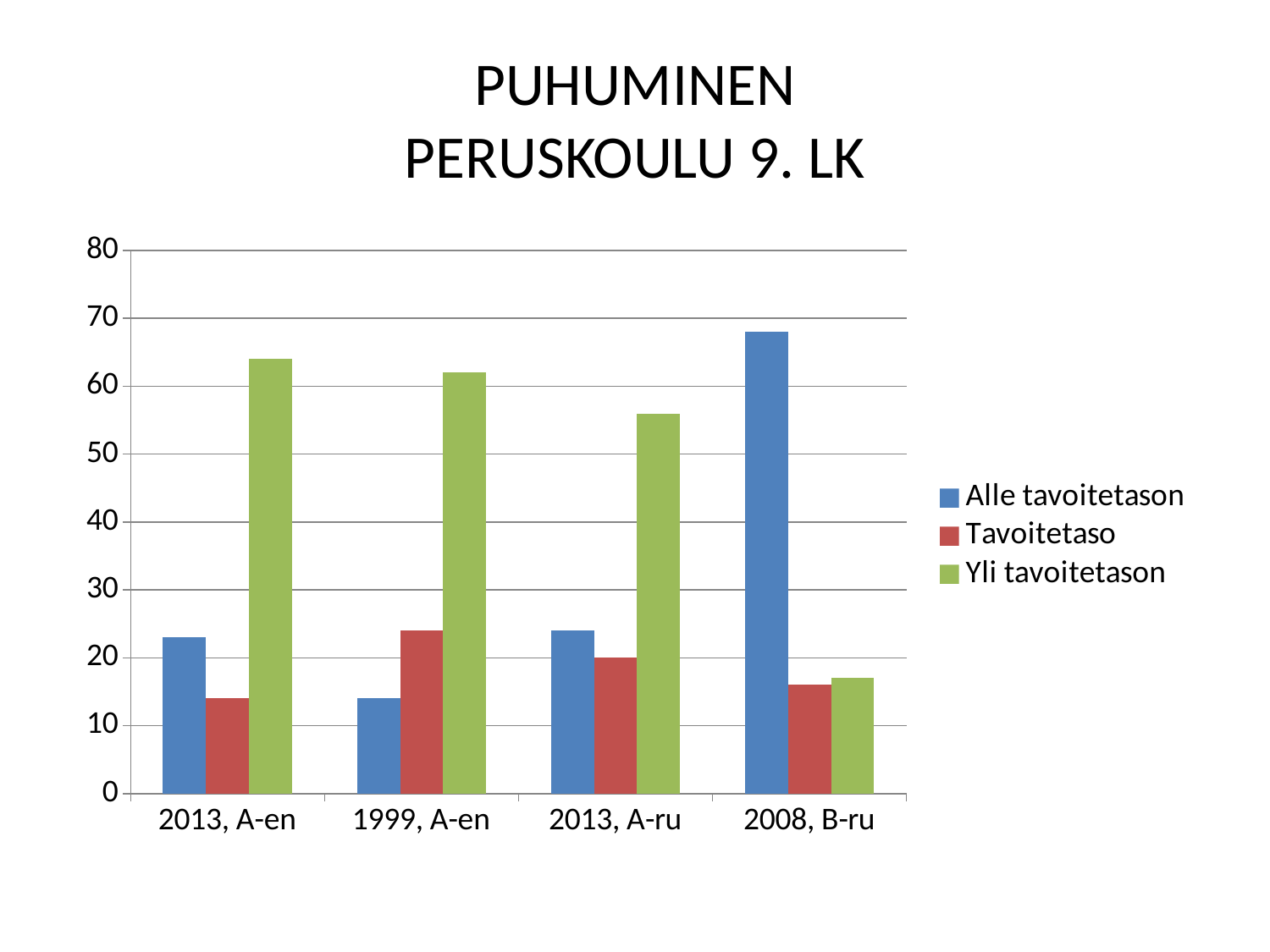
Which category has the lowest value for Yli tavoitetason? 2008, B-ru Is the value for Tavoitetaso in 2013, A-en greater or less than 20? less How many categories are shown on the x axis? 4 Which category has the lowest value for Alle tavoitetason? 1999, A-en In 2013, A-en, which is larger: Alle tavoitetason or Tavoitetaso? Alle tavoitetason Which category has the highest value for Tavoitetaso? 1999, A-en What kind of chart is shown on the slide? bar chart Which category has the highest value for Alle tavoitetason? 2008, B-ru Is the value for Alle tavoitetason in 2008, B-ru greater or less than 60? greater What is the title of the chart? PUHUMINEN PERUSKOULU 9. LK How many series does the legend list? 3 Is the value for Yli tavoitetason in 2013, A-ru greater or less than 50? greater